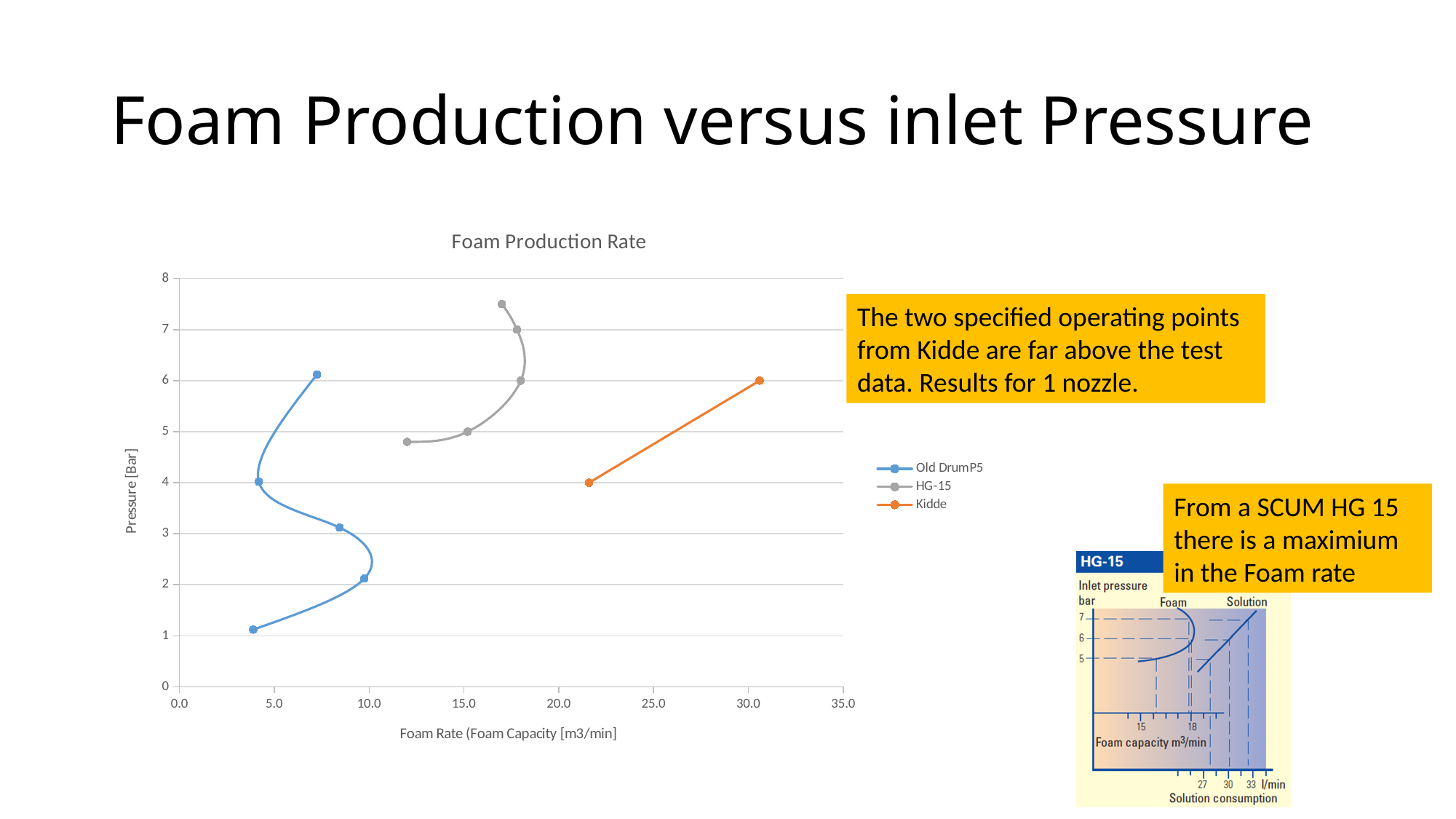
What kind of chart is shown on the slide? Scatter chart with smoothed lines Which series reaches the highest foam rate on the chart? Kidde How many data points are plotted for the Old DrumP5 series? 5 Is the foam rate of the Kidde point at 6 bar greater or less than 25.0? greater What is the pressure of the upper Kidde operating point? 6 Is the foam rate of the Old DrumP5 point at about 4 bar greater or less than 5.0? less What is the pressure of the lower Kidde operating point? 4 How many data points are plotted for the HG-15 series? 5 How many series does the legend of the Foam Production Rate chart list? 3 What are the three series named in the legend of the Foam Production Rate chart? Old DrumP5, HG-15, Kidde What is the label of the vertical axis of the Foam Production Rate chart? Pressure [Bar] How many data points are plotted for the Kidde series? 2